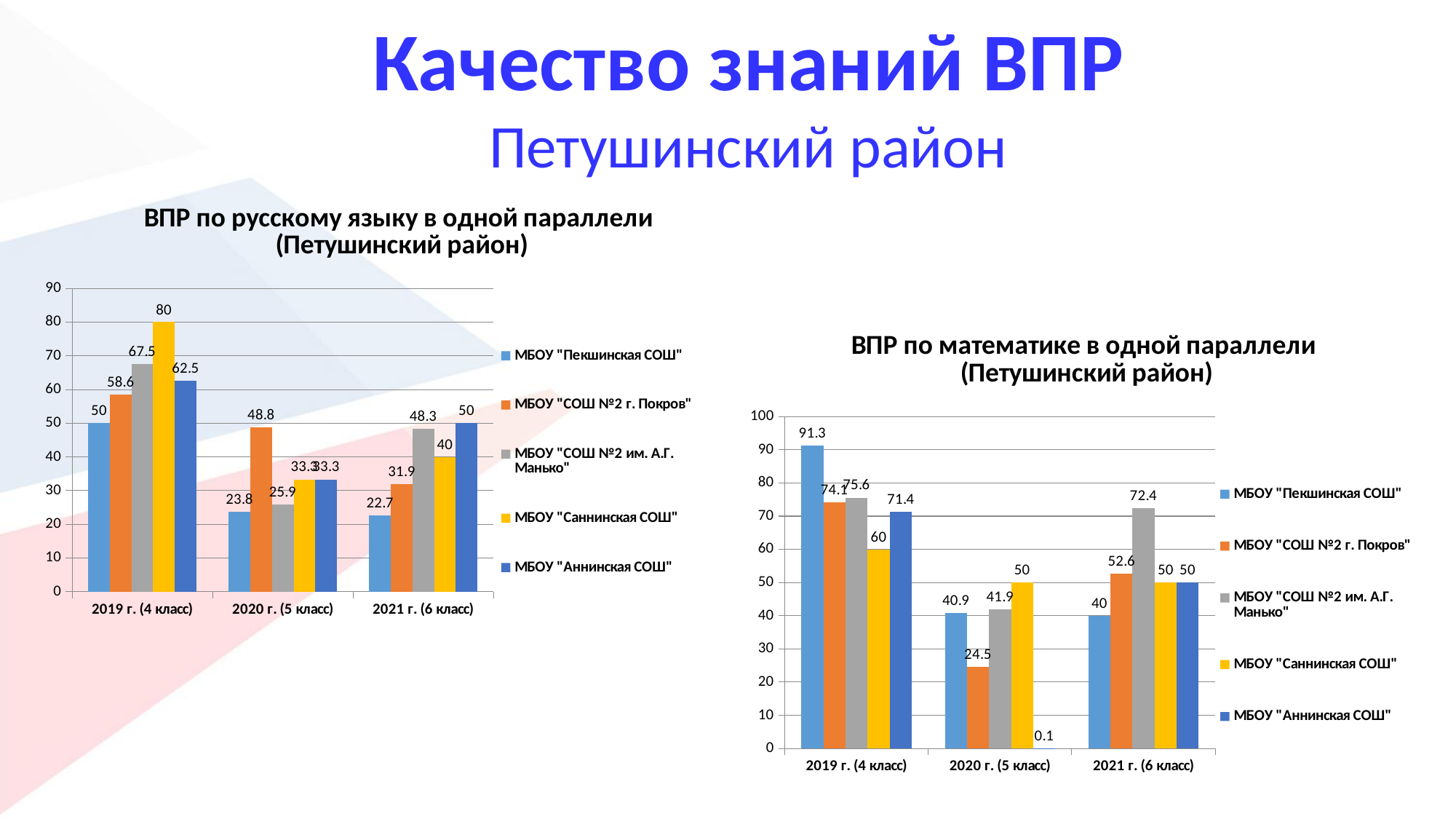
In the chart "ВПР по русскому языку в одной параллели", do the values for МБОУ "Пекшинская СОШ" rise or fall from 2019 to 2021? Fall How many series does the legend of the chart "ВПР по русскому языку в одной параллели" list? 5 In the chart "ВПР по русскому языку в одной параллели", what is the difference between the values for МБОУ "Саннинская СОШ" and МБОУ "Пекшинская СОШ" in 2019 г. (4 класс)? 30 In the chart "ВПР по русскому языку в одной параллели", what is the value for МБОУ "Саннинская СОШ" in 2019 г. (4 класс)? 80 What kind of chart is "ВПР по русскому языку в одной параллели"? Bar chart In the chart "ВПР по русскому языку в одной параллели", which school has the highest value in 2020 г. (5 класс)? МБОУ "СОШ №2 г. Покров" In the chart "ВПР по математике в одной параллели", what is the value for МБОУ "Пекшинская СОШ" in 2019 г. (4 класс)? 91.3 In the chart "ВПР по математике в одной параллели", which is larger in 2020 г. (5 класс): the value for МБОУ "Саннинская СОШ" or МБОУ "СОШ №2 г. Покров"? МБОУ "Саннинская СОШ" In the chart "ВПР по математике в одной параллели", what is the difference between the values for МБОУ "СОШ №2 им. А.Г. Манько" and МБОУ "СОШ №2 г. Покров" in 2021 г. (6 класс)? 19.8 How many categories are shown on the x axis of the chart "ВПР по математике в одной параллели"? 3 In the chart "ВПР по математике в одной параллели", which school has the lowest value in 2021 г. (6 класс)? МБОУ "Пекшинская СОШ" In the chart "ВПР по математике в одной параллели", what is the value for МБОУ "Аннинская СОШ" in 2020 г. (5 класс)? 0.1